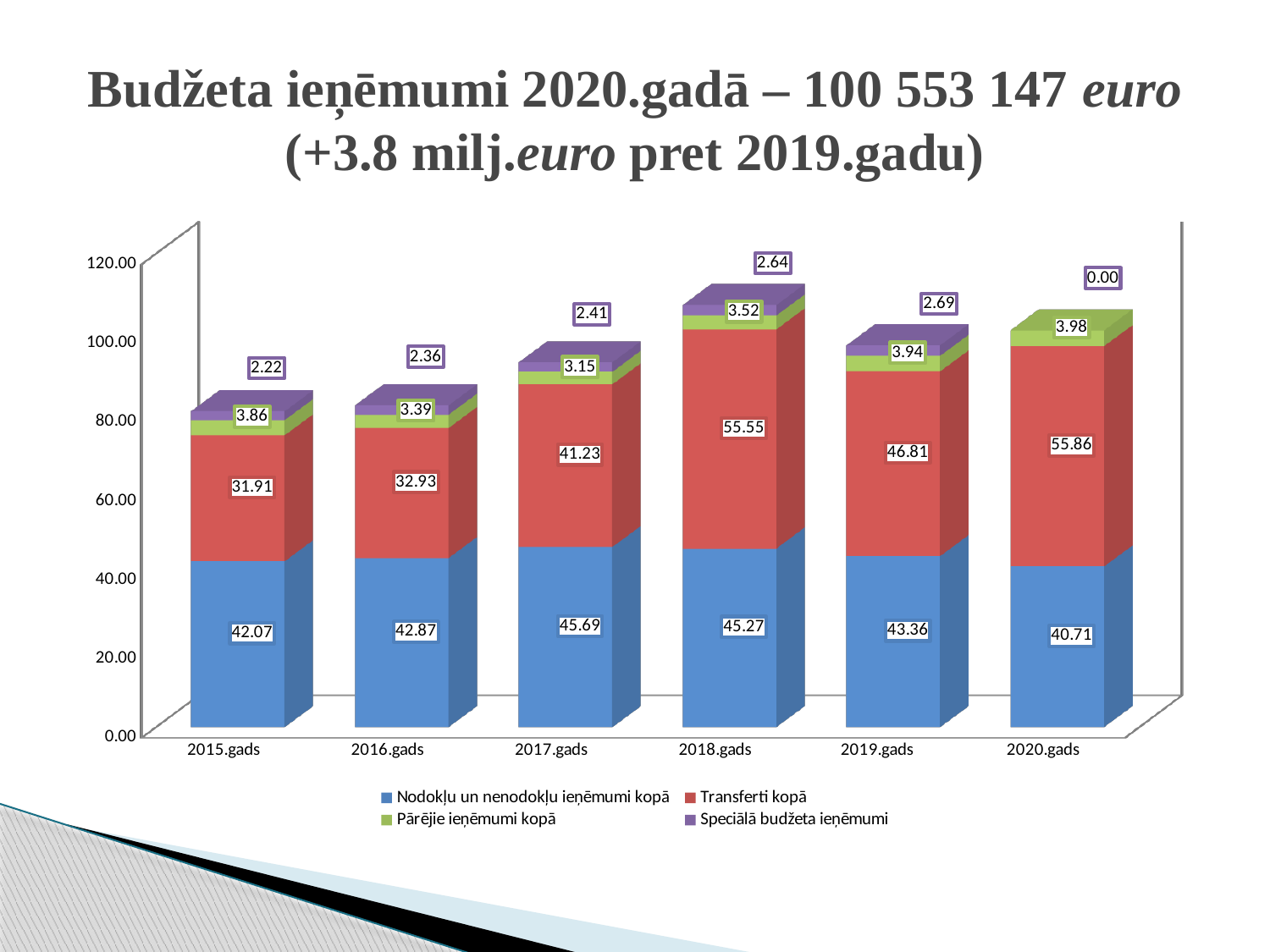
What is the total of the stacked bar for 2018.gads? 106.98 What is the value of Speciālā budžeta ieņēmumi for 2020.gads? 0.00 Which legend entry is shown in red? Transferti kopā What is the value of Nodokļu un nenodokļu ieņēmumi kopā for 2020.gads? 40.71 What kind of chart is shown on the slide? Stacked bar chart How many series does the legend list? 4 Which year has the lowest value for Transferti kopā? 2015.gads What is the value of Transferti kopā for 2018.gads? 55.55 Which year has the highest value for Nodokļu un nenodokļu ieņēmumi kopā? 2017.gads What is the difference between Transferti kopā in 2020.gads and 2019.gads? 9.05 How many years are shown on the x axis? 6 Which is larger: Pārējie ieņēmumi kopā in 2019.gads or in 2020.gads? 2020.gads